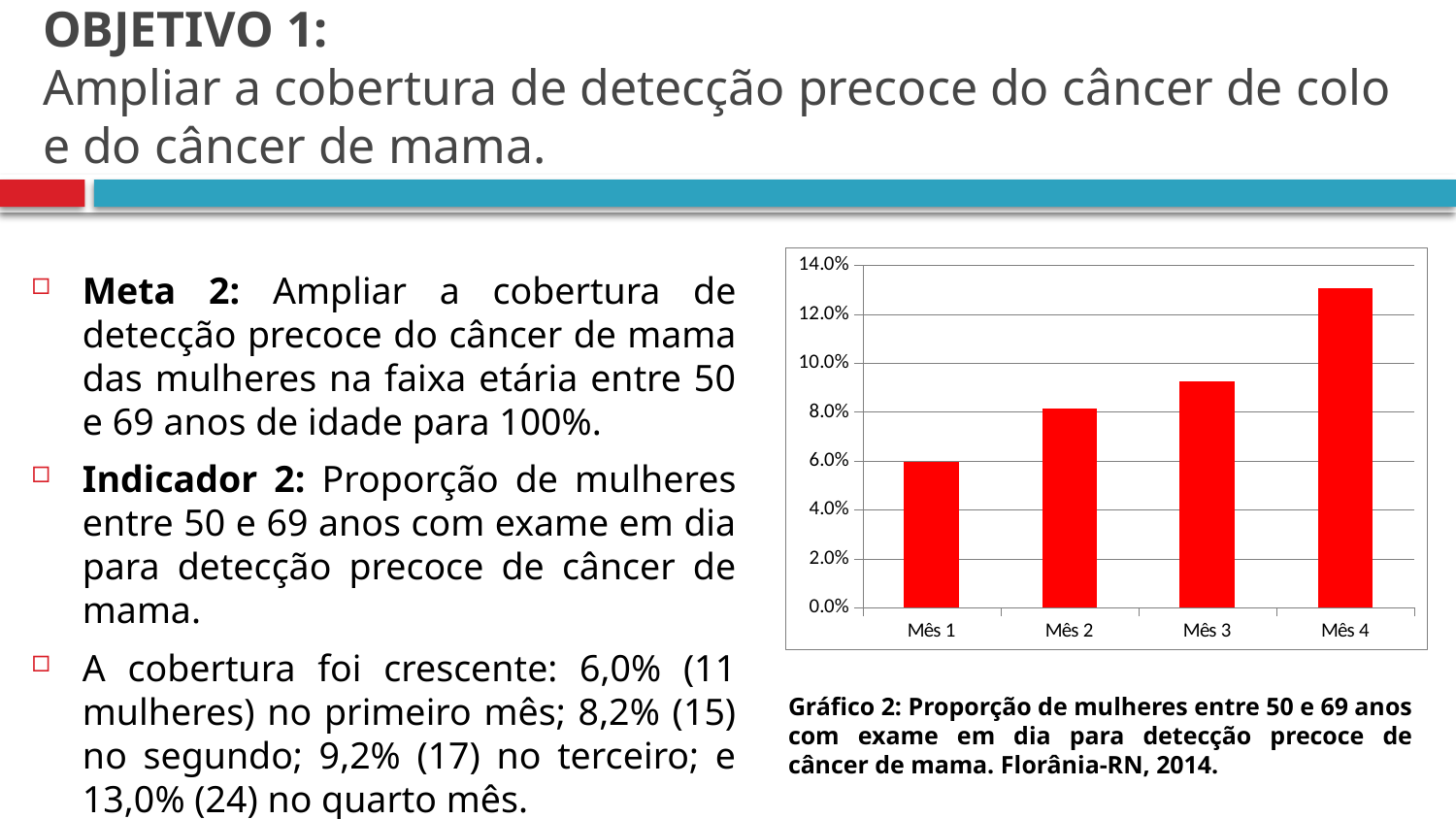
Which month has the highest bar on the chart? Mês 4 Is the value for Mês 4 greater or less than 12.0%? greater What is the highest value shown on the chart's vertical axis? 14.0% How many categories (months) are plotted on the chart? 4 Is the value for Mês 3 greater or less than 8.0%? greater Which month has the lowest bar on the chart? Mês 1 What colour are the bars in the chart? red Is the value for Mês 2 greater or less than 10.0%? less Which is larger, the value for Mês 2 or the value for Mês 3? Mês 3 Do the values rise or fall from Mês 1 to Mês 4? rise What kind of chart is shown on the slide? bar chart